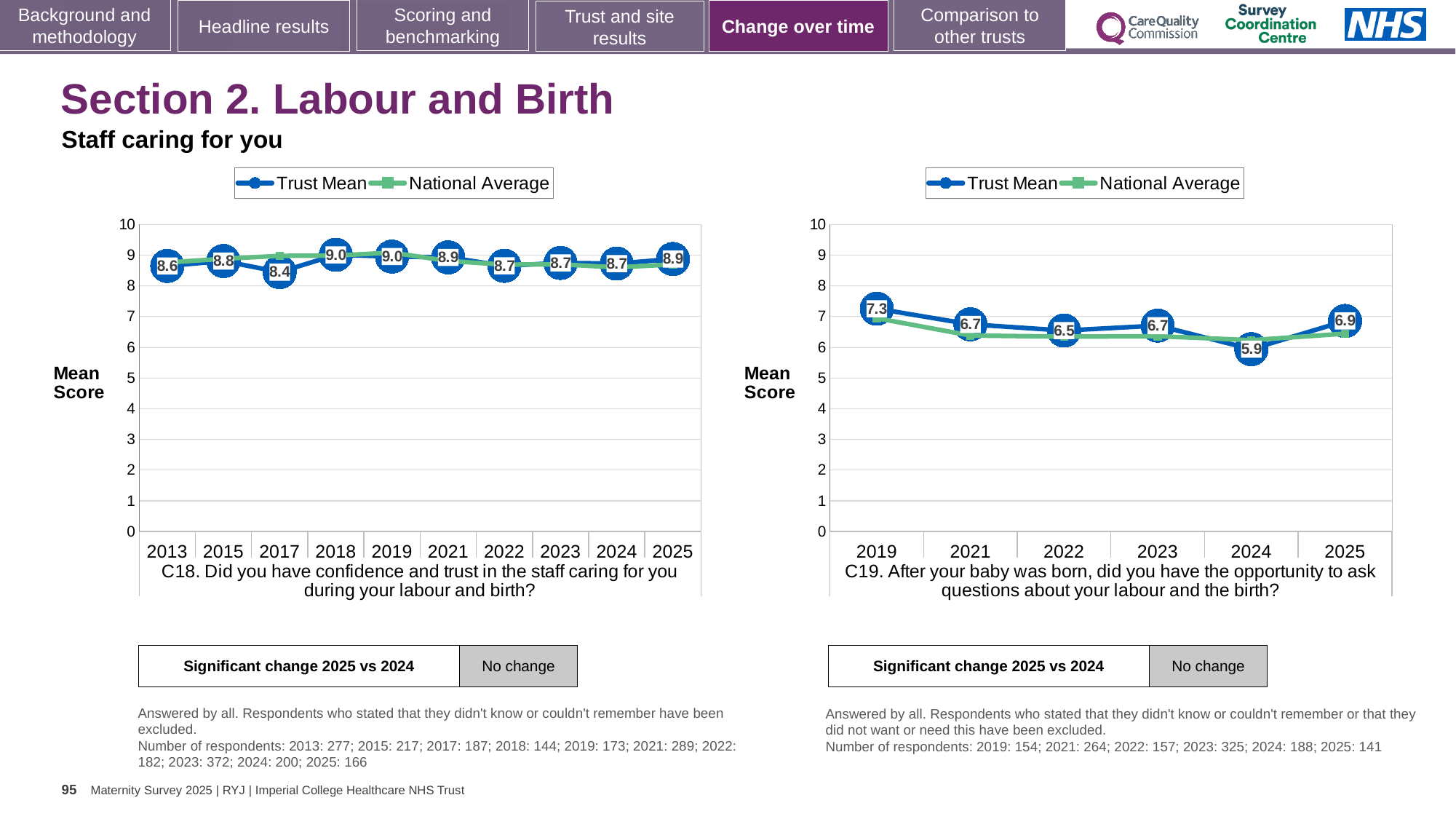
In the C19 chart on the right, what is the Trust Mean for 2019? 7.3 In the C19 chart on the right, what is the difference between the Trust Mean for 2025 and 2024? 1.0 What kind of chart is the C18 chart on the left? Line chart In the C18 chart on the left, which year has the lowest Trust Mean? 2017 In the C19 chart on the right, which year has the highest Trust Mean? 2019 In the C18 chart on the left, how many years are shown on the x axis? 10 In the C19 chart on the right, is the Trust Mean for 2024 greater or less than 6? less In the C19 chart on the right, which year has the lowest Trust Mean? 2024 In the C18 chart on the left, what is the Trust Mean for 2025? 8.9 In the C18 chart on the left, what is the Trust Mean for 2017? 8.4 In the C18 chart on the left, what is the difference between the Trust Mean for 2018 and 2017? 0.6 How many series does the legend of the C19 chart on the right list? 2